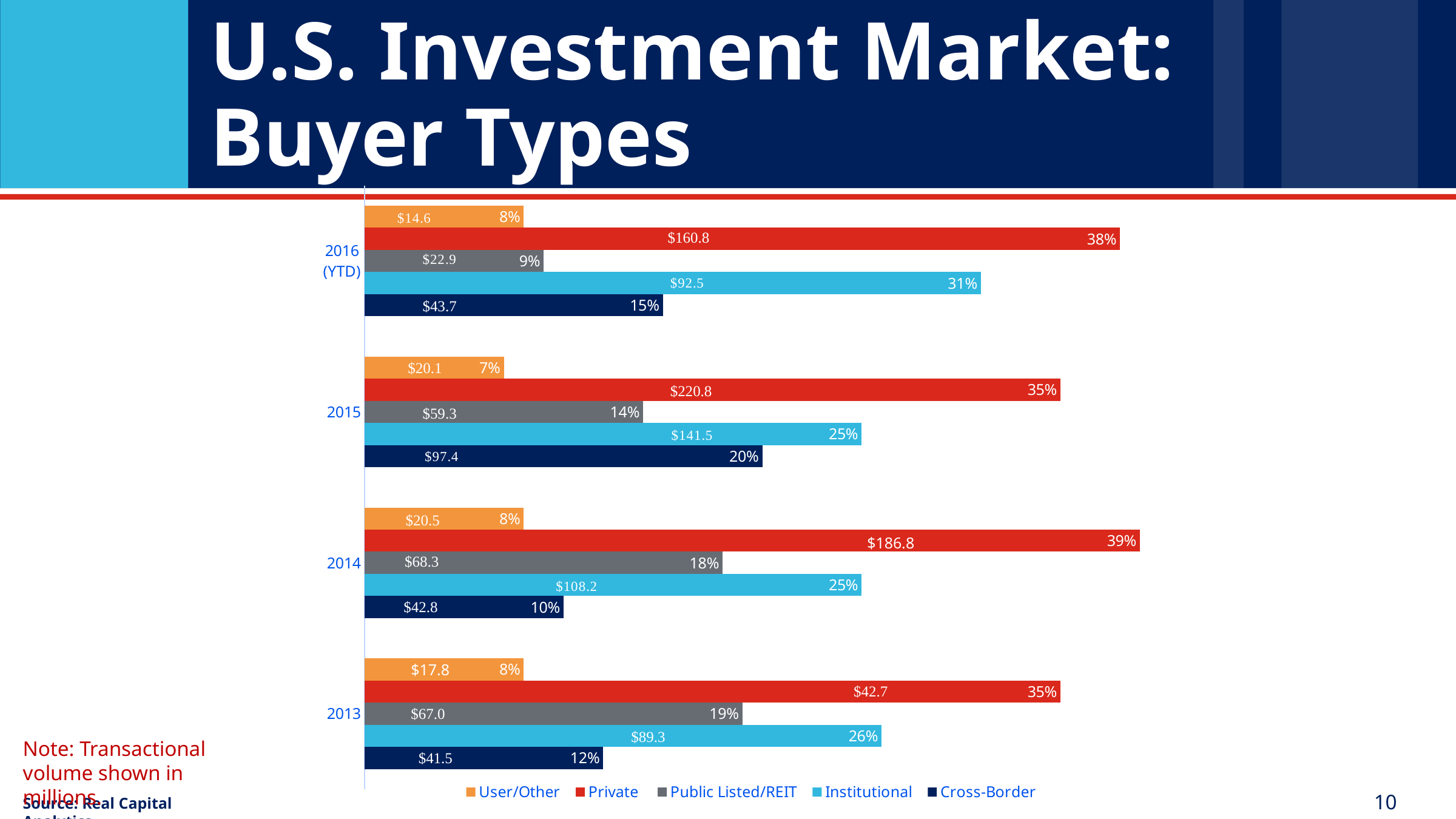
What was the transactional volume for Institutional buyers in 2015? $141.5 In 2013, which had the larger share: Public Listed/REIT or Cross-Border? Public Listed/REIT What colour represents Institutional buyers in the legend? light blue What share of the market did Private buyers have in 2016 (YTD)? 38% Which buyer type had the lowest share in 2015? User/Other How many buyer types does the legend list? 5 What share of the market did Cross-Border buyers have in 2015? 20% How many year categories are shown on the chart? 4 Which buyer type had the highest share in 2014? Private In 2014, how many percentage points higher was the Private share than the Cross-Border share? 29 What kind of chart is shown on the slide? bar chart In which year was the Private buyer transactional volume highest? 2015